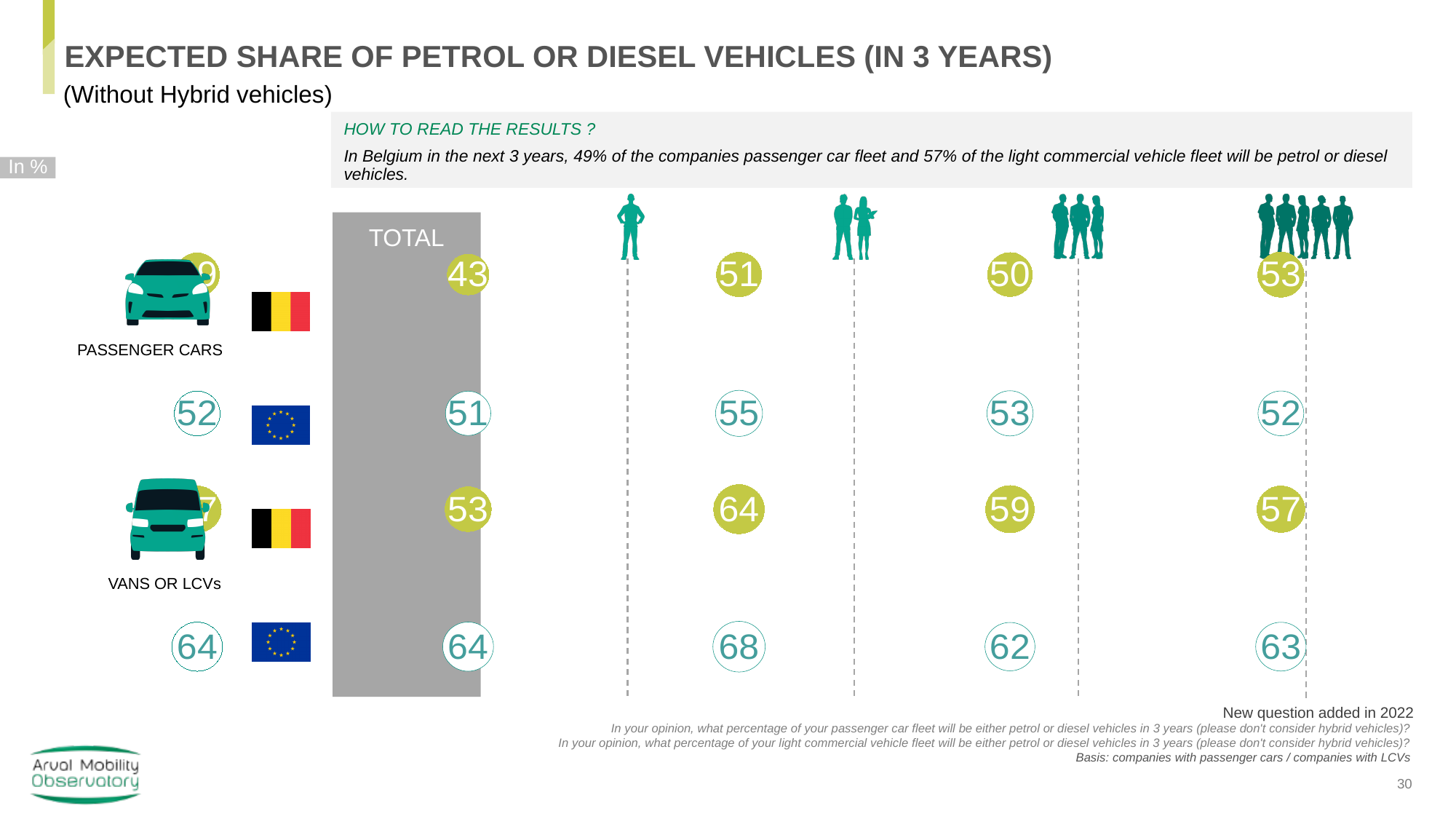
In what unit are the values on this slide expressed? In % Which is larger: the TOTAL value for passenger cars in Europe or the TOTAL value for passenger cars in Belgium? Europe (51) What is the TOTAL value for passenger cars in the European (EU flag) row? 51 What is the TOTAL value for vans or LCVs in the European (EU flag) row? 64 What is the difference between the TOTAL value for vans or LCVs in Belgium and the TOTAL value for passenger cars in Belgium? 10 What is the TOTAL value for passenger cars in Belgium (Belgian flag row)? 43